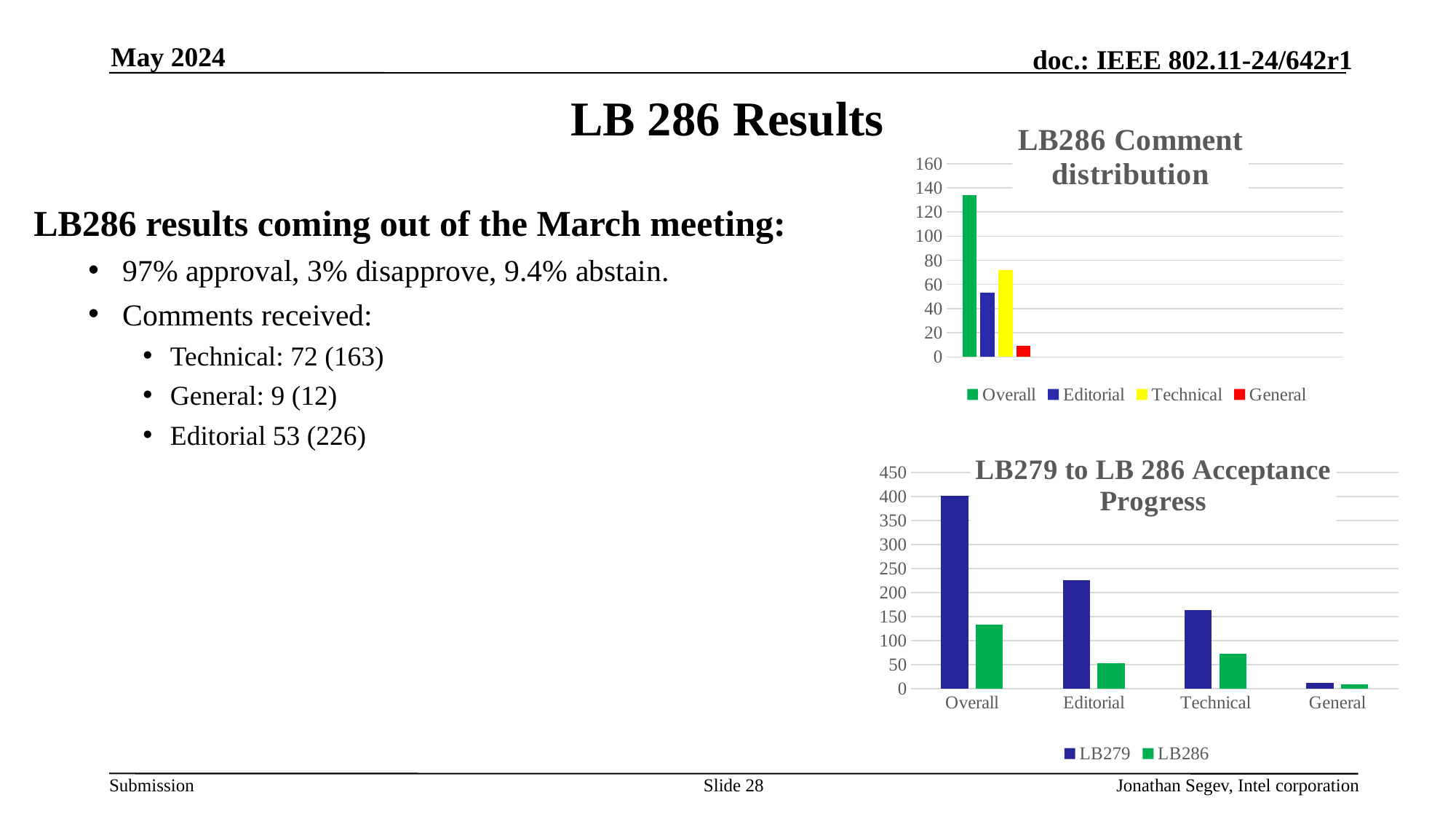
In the LB279 to LB 286 Acceptance Progress chart, which is larger for Editorial, LB279 or LB286? LB279 In the LB279 to LB 286 Acceptance Progress chart, which category has the highest LB279 value? Overall How many series does the legend of the LB286 Comment distribution chart list? 4 How many categories are shown on the x axis of the LB279 to LB 286 Acceptance Progress chart? 4 In the LB279 to LB 286 Acceptance Progress chart, what colour are the LB286 bars? green In the LB286 Comment distribution chart, which is larger, Editorial or Technical? Technical In the LB279 to LB 286 Acceptance Progress chart, is the LB279 value for Overall greater or less than 350? greater In the LB286 Comment distribution chart, which series has the shortest bar? General In the LB286 Comment distribution chart, is the value for Overall greater or less than 120? greater What kind of chart is the LB279 to LB 286 Acceptance Progress chart? bar chart In the LB286 Comment distribution chart, which series has the tallest bar? Overall In the LB286 Comment distribution chart, is the value for Technical greater or less than 80? less